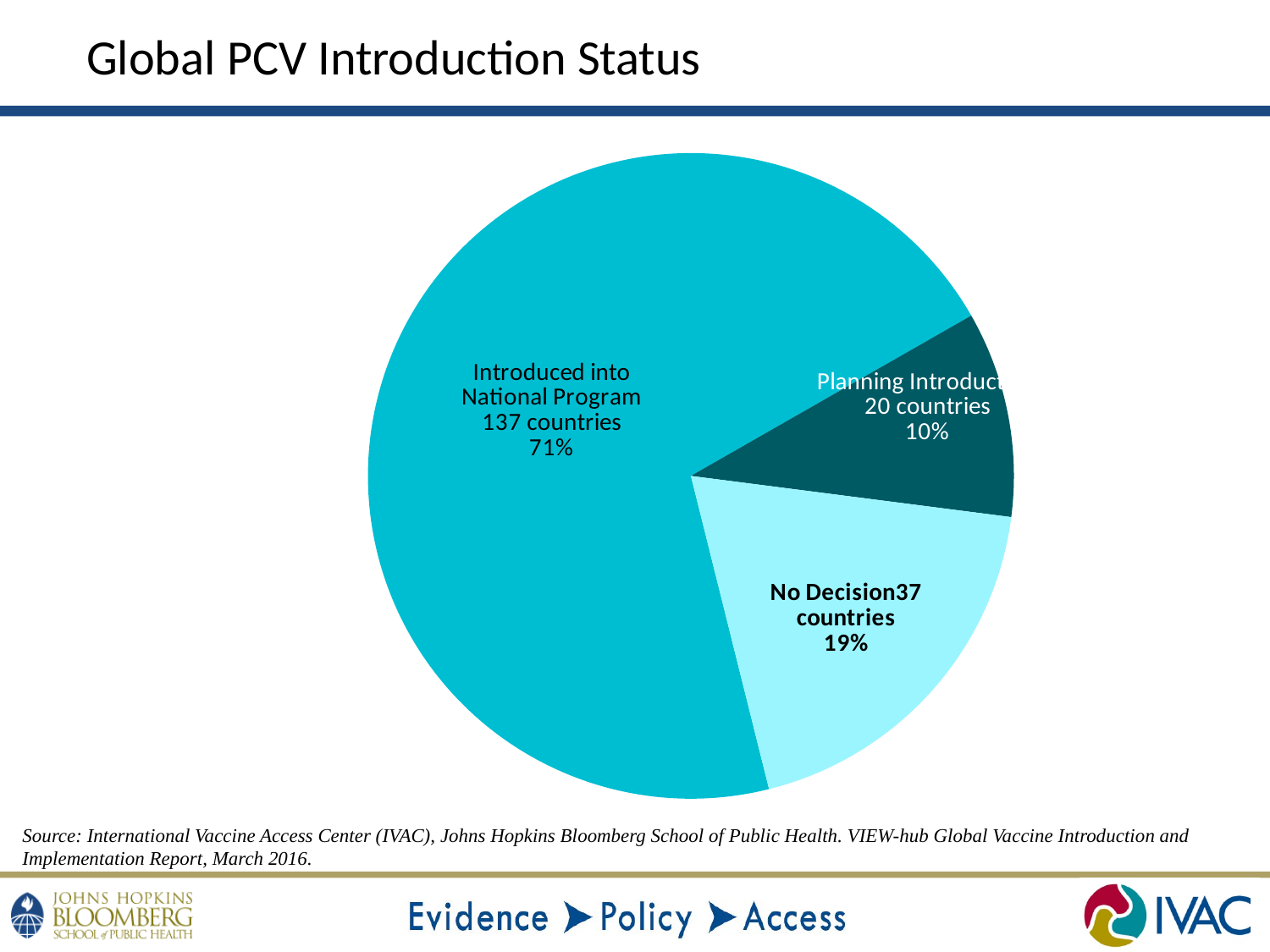
What share of the pie does the Introduced into National Program slice represent? 71% How many countries are in the No Decision category? 37 countries How many more countries are in the Introduced into National Program category than in the No Decision category? 100 countries What share of the pie does the No Decision slice represent? 19% Which category has the smallest slice of the pie? Planning Introduction How many slices does the pie chart have? 3 Which category has the largest slice of the pie? Introduced into National Program What share of the pie does the Planning Introduction slice represent? 10% What kind of chart is shown on the slide? Pie chart How many countries are in the Planning Introduction category? 20 countries What is the title of the slide? Global PCV Introduction Status How many countries have introduced PCV into their national program? 137 countries